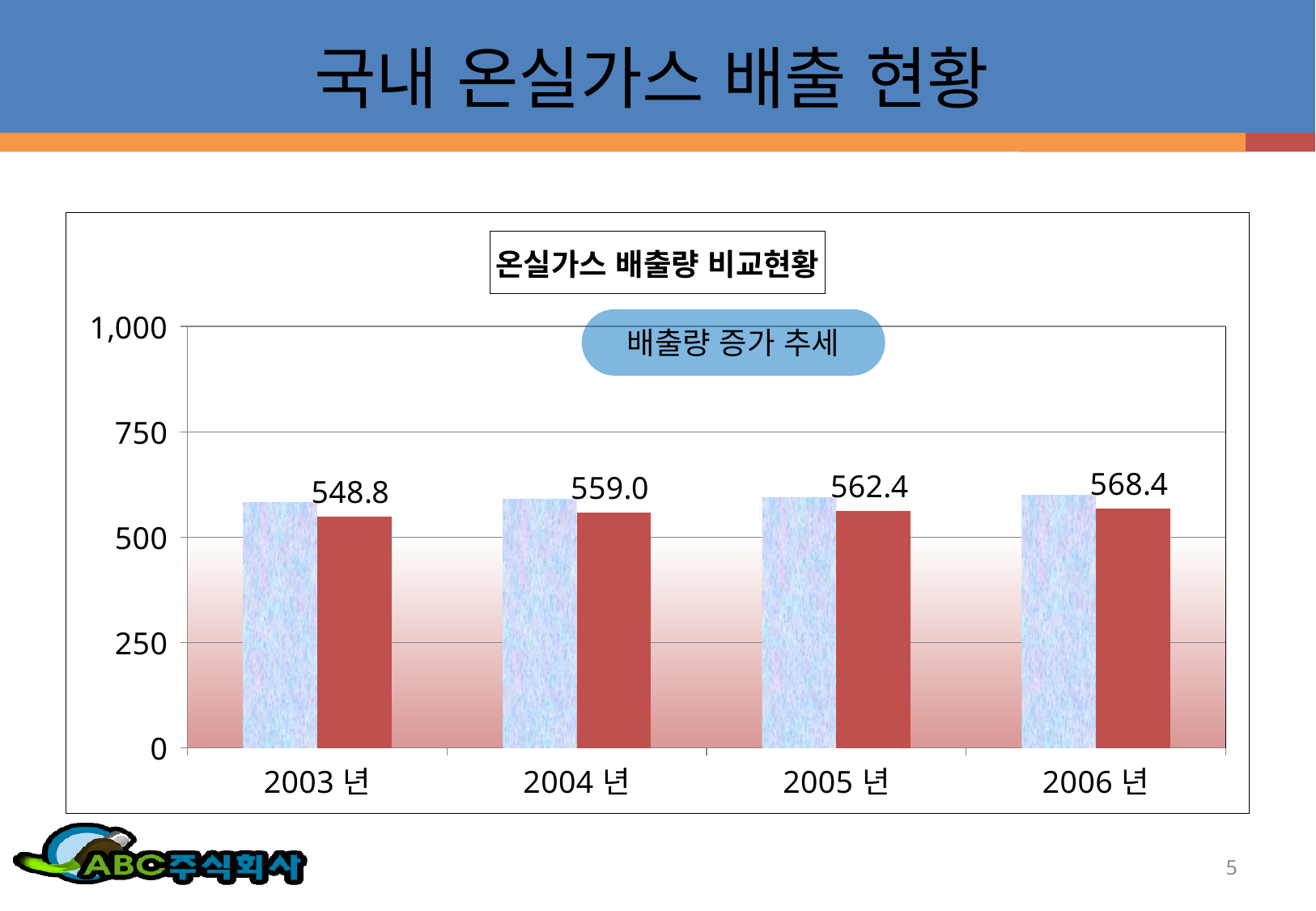
Is the labelled value for 2006 년 greater or less than 750? less What is the data label shown for 2003 년? 548.8 What is the data label shown for 2006 년? 568.4 How many years are shown on the x axis? 4 Which is larger, the labelled value for 2004 년 or for 2005 년? 2005 년 Which year has the lowest labelled value? 2003 년 What is the difference between the labelled values for 2006 년 and 2003 년? 19.6 What kind of chart is shown on the slide? bar chart Do the labelled values rise or fall from 2003 년 to 2006 년? rise What is the data label shown for 2005 년? 562.4 What is the data label shown for 2004 년? 559.0 Which year has the highest labelled value? 2006 년